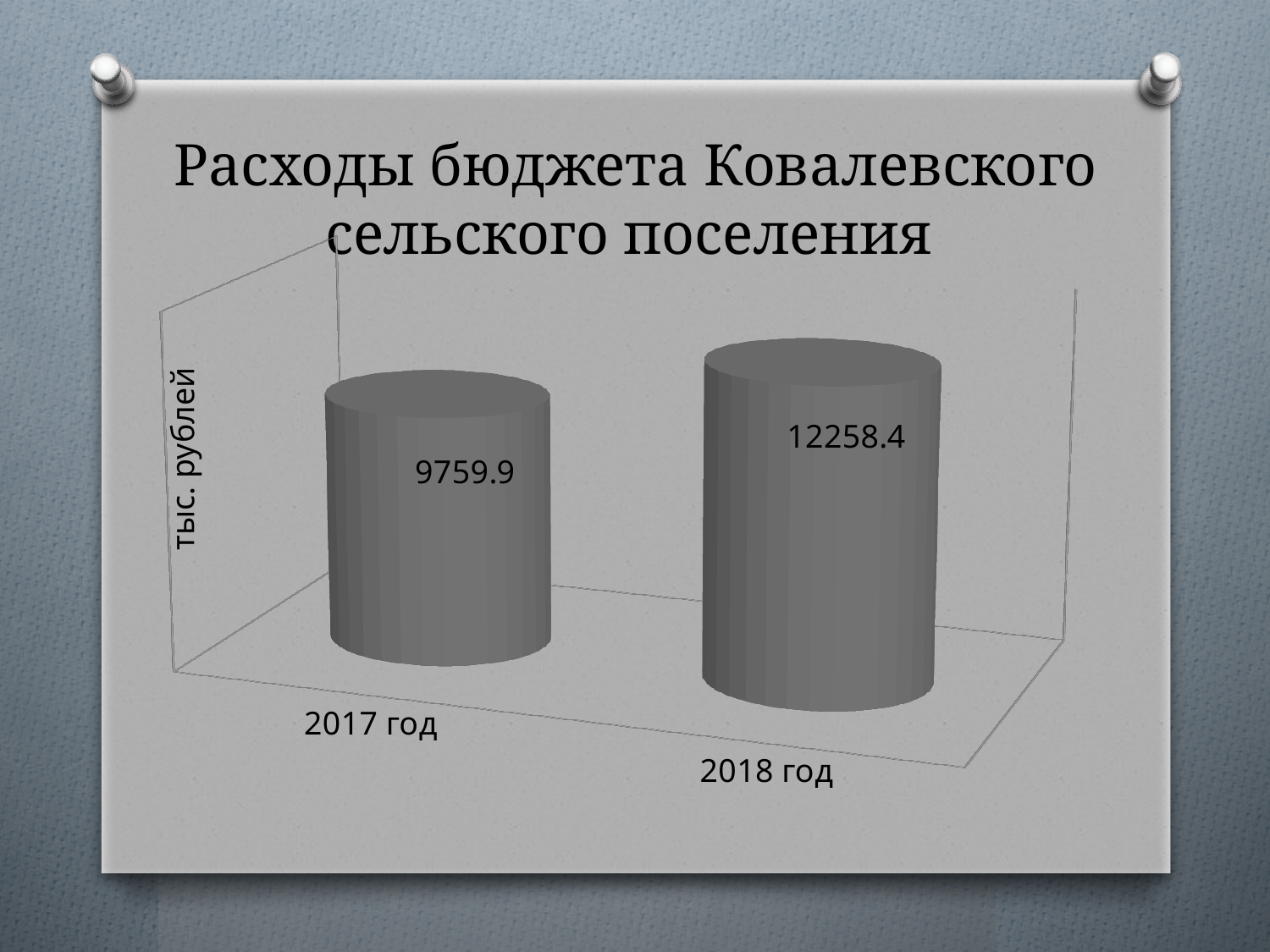
What kind of chart is shown on the slide? bar chart What is the difference between the values for 2018 год and 2017 год? 2498.5 What is the title of the chart? Расходы бюджета Ковалевского сельского поселения Which year has the lowest value? 2017 год What is the value for 2017 год? 9759.9 Do the values rise or fall from 2017 год to 2018 год? rise Which year has the highest value? 2018 год What is the label on the vertical axis? тыс. рублей What is the value for 2018 год? 12258.4 How many categories are shown in the chart? 2 Which is larger, the value for 2017 год or the value for 2018 год? 2018 год